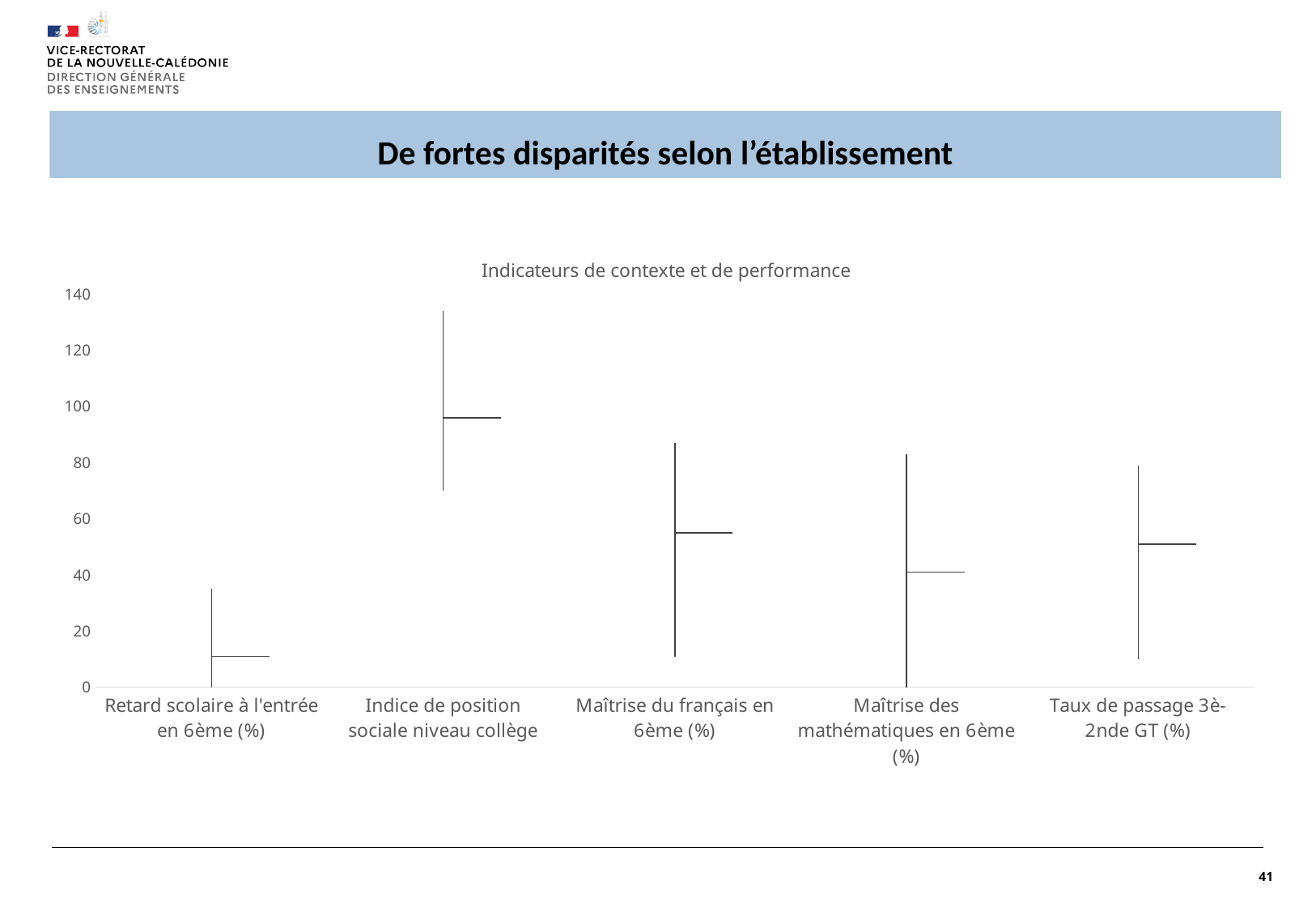
What is the title of the chart? Indicateurs de contexte et de performance Is the marker value for Taux de passage 3è-2nde GT (%) greater or less than 60? less Is the marker value for Maîtrise des mathématiques en 6ème (%) greater or less than 60? less Which category has the lowest marker value in the chart? Retard scolaire à l'entrée en 6ème (%) How many categories are shown on the x axis of the chart? 5 Is the marker value for Retard scolaire à l'entrée en 6ème (%) greater or less than 20? less What is the maximum value shown on the vertical axis of the chart? 140 Which category has the highest marker value in the chart? Indice de position sociale niveau collège Which has the larger marker value: Maîtrise du français en 6ème (%) or Maîtrise des mathématiques en 6ème (%)? Maîtrise du français en 6ème (%)